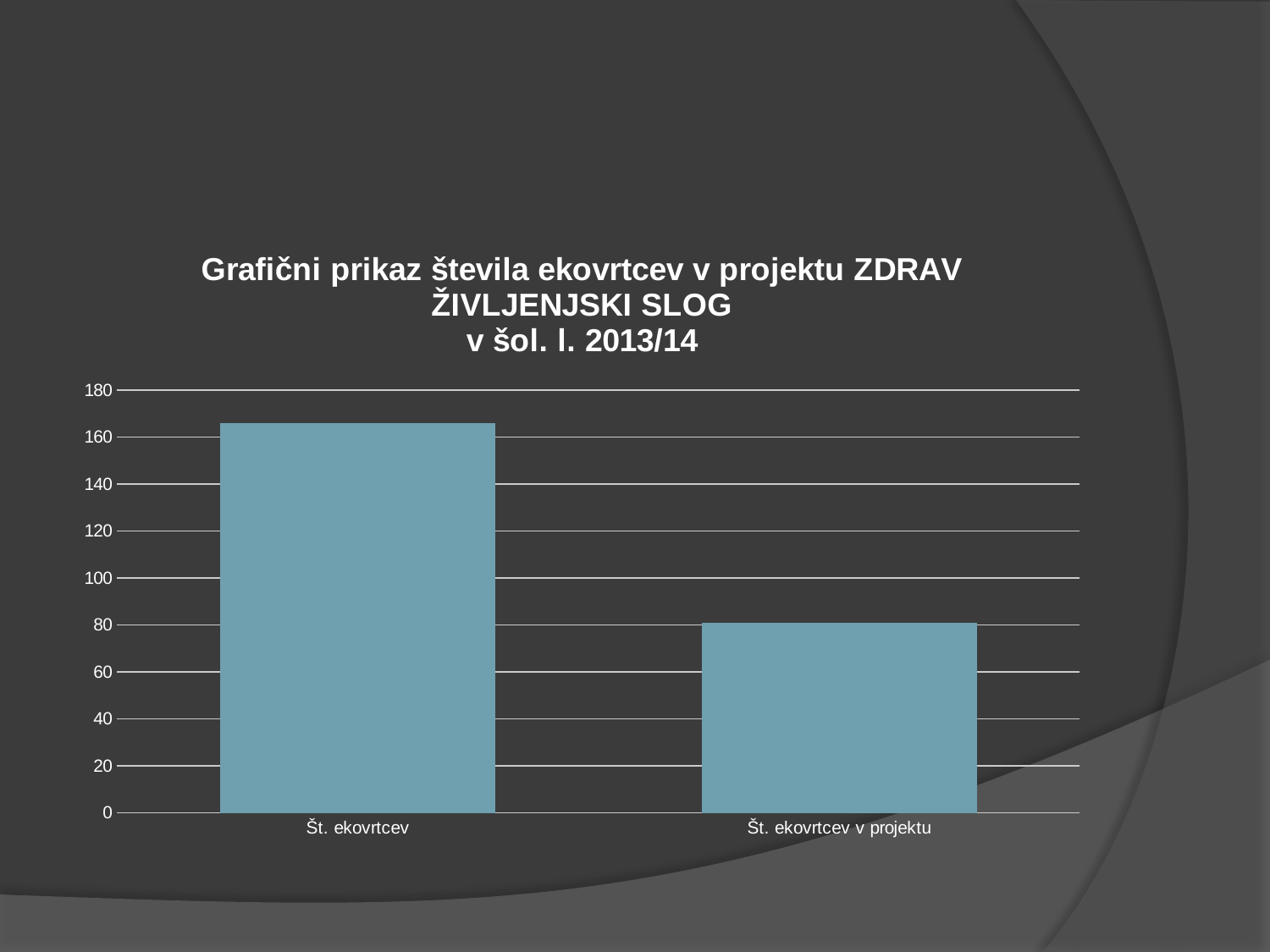
What kind of chart is shown on the slide? bar chart Is the value for Št. ekovrtcev greater or less than 140? greater How many categories are plotted in the chart? 2 What school year is named in the chart title? 2013/14 What is the highest value shown on the vertical axis of the chart? 180 Is the value for Št. ekovrtcev greater or less than 180? less Is the value for Št. ekovrtcev greater or less than 160? greater Which category has the lowest value? Št. ekovrtcev v projektu Which is larger, the value for Št. ekovrtcev or the value for Št. ekovrtcev v projektu? Št. ekovrtcev Which category has the highest value? Št. ekovrtcev